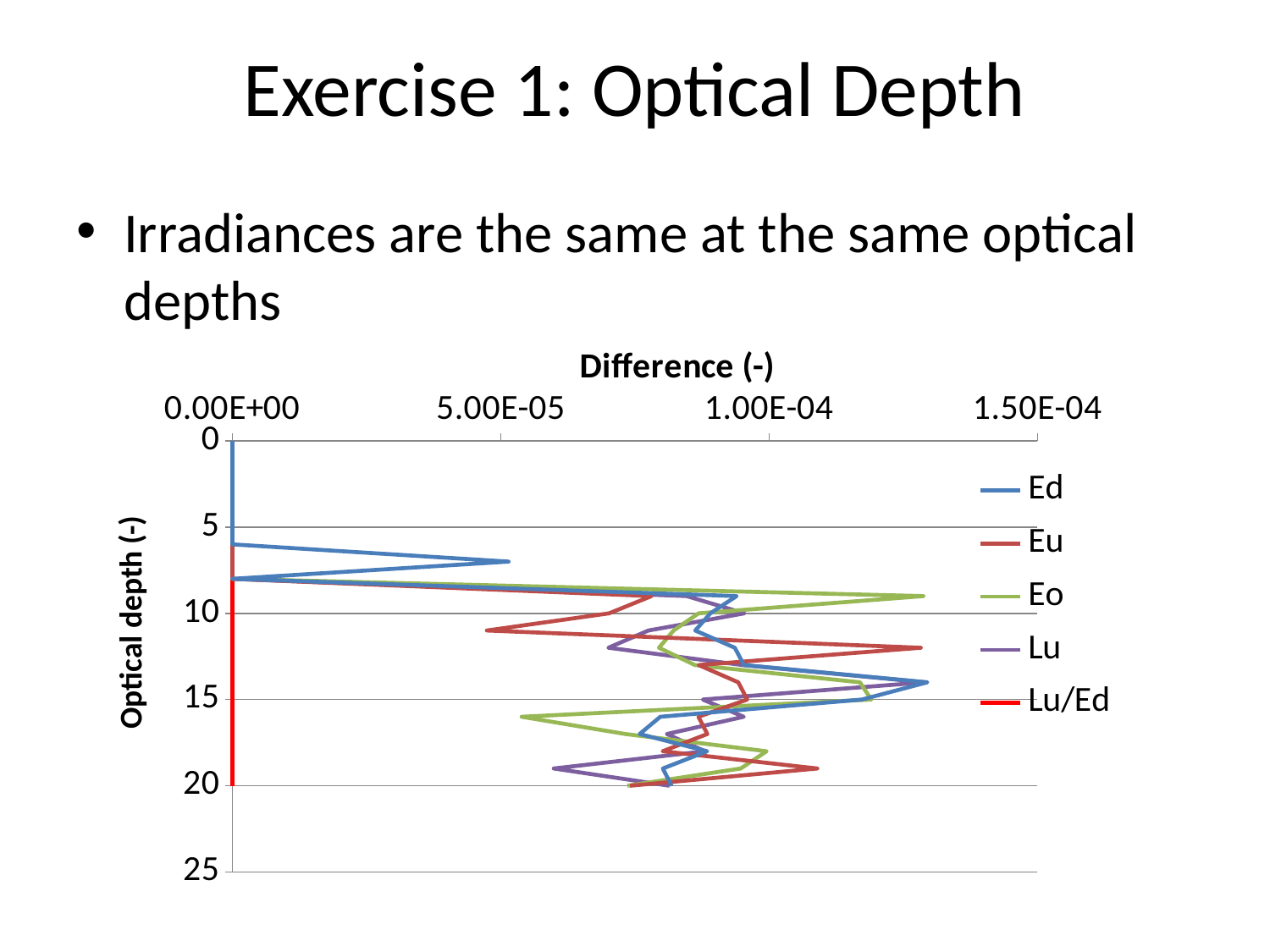
Is the Eu value at optical depth 12 greater or less than 1.00E-04? greater How many series does the chart legend list? 5 Is the Lu/Ed value at optical depth 15 greater or less than 5.00E-05? less At optical depth 12, which series has the larger Difference value, Eu or Lu? Eu What kind of chart is shown on the slide? line chart What is the title of the vertical axis of the chart? Optical depth (-) At optical depth 9, which series has the larger Difference value, Eo or Eu? Eo What are the series names listed in the chart legend? Ed, Eu, Eo, Lu, Lu/Ed Is the Ed value at optical depth 3 greater or less than 5.00E-05? less